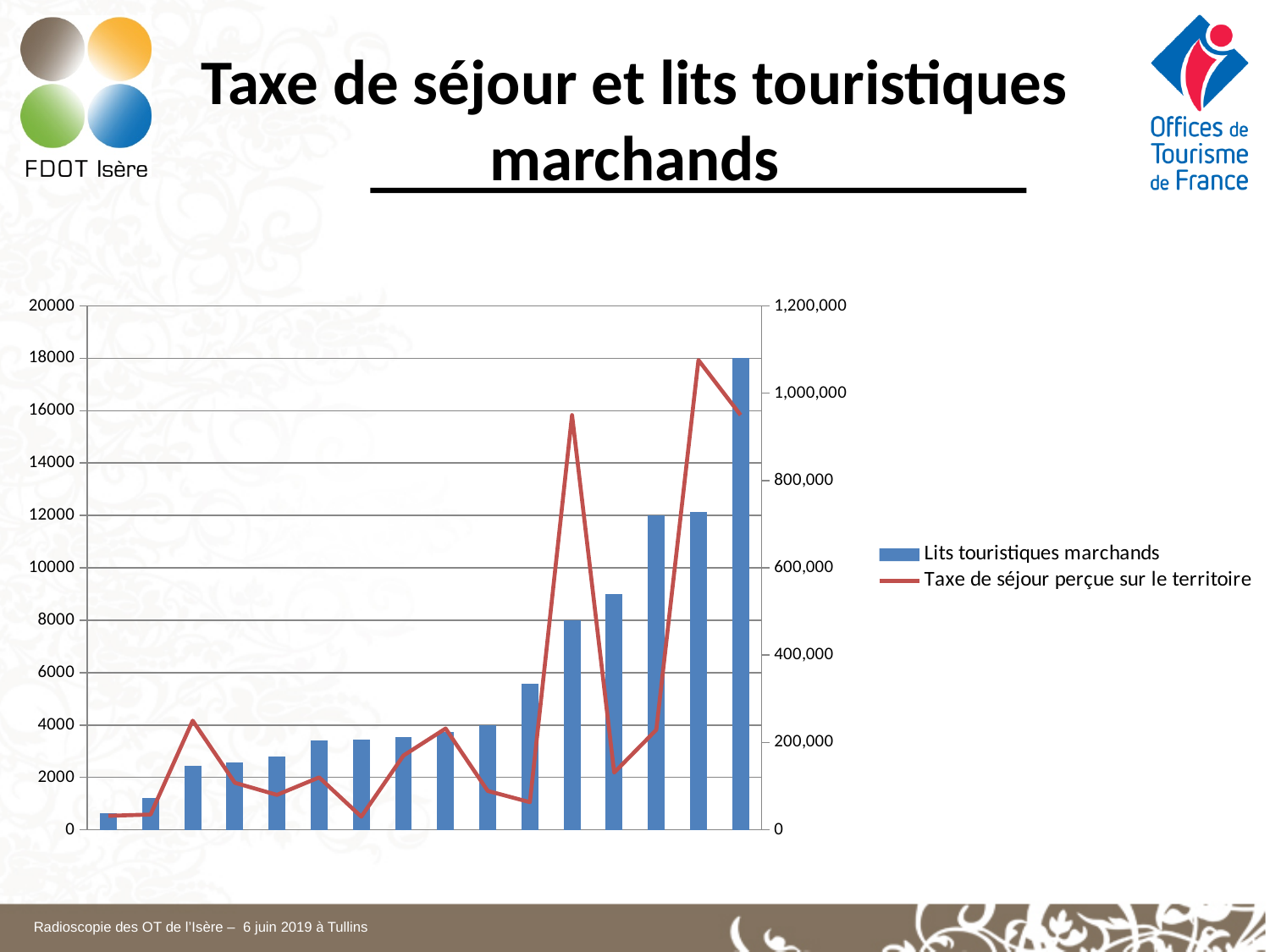
How many bars are plotted for Lits touristiques marchands? 16 Which bar is the tallest for Lits touristiques marchands, the first or the last? The last What are the two series named in the legend? Lits touristiques marchands; Taxe de séjour perçue sur le territoire Is the value of the tallest bar for Lits touristiques marchands greater or less than 16000? greater Do the values for Lits touristiques marchands generally rise or fall from left to right? Rise Is the first (leftmost) point of the Taxe de séjour perçue sur le territoire line greater or less than 200,000? less What kind of chart is shown on the slide? Combined bar and line chart Which series is drawn as a red line? Taxe de séjour perçue sur le territoire What is the maximum value shown on the right-hand axis? 1,200,000 Is the value of the first (leftmost) bar for Lits touristiques marchands greater or less than 2000? less How many series does the legend list? 2